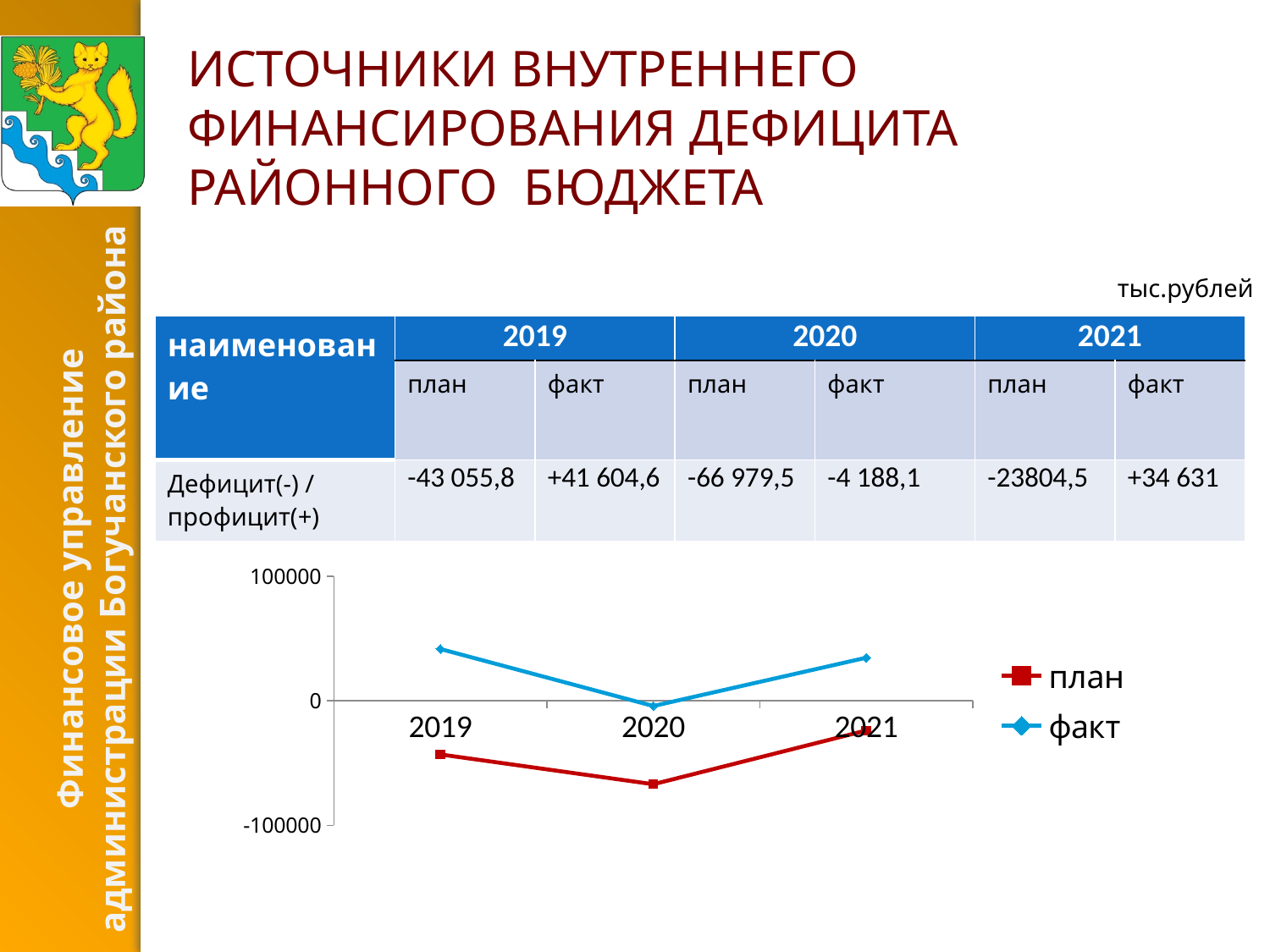
What is the факт value for 2021 (тыс.рублей)? +34 631 What is the план value for 2020 (тыс.рублей)? -66 979,5 How many series does the chart legend list? 2 Which colour is used for the план series in the chart? red Does the план series rise or fall from 2020 to 2021? rises In which year is the план series at its lowest? 2020 What is the difference between факт and план for 2021 (тыс.рублей)? 58 435,5 For 2019, which is larger: план or факт? факт How many years are plotted along the x axis of the chart? 3 Is the план value for 2019 greater or less than 0? less What kind of chart is shown on the slide? line chart In which year is the факт series at its highest? 2019